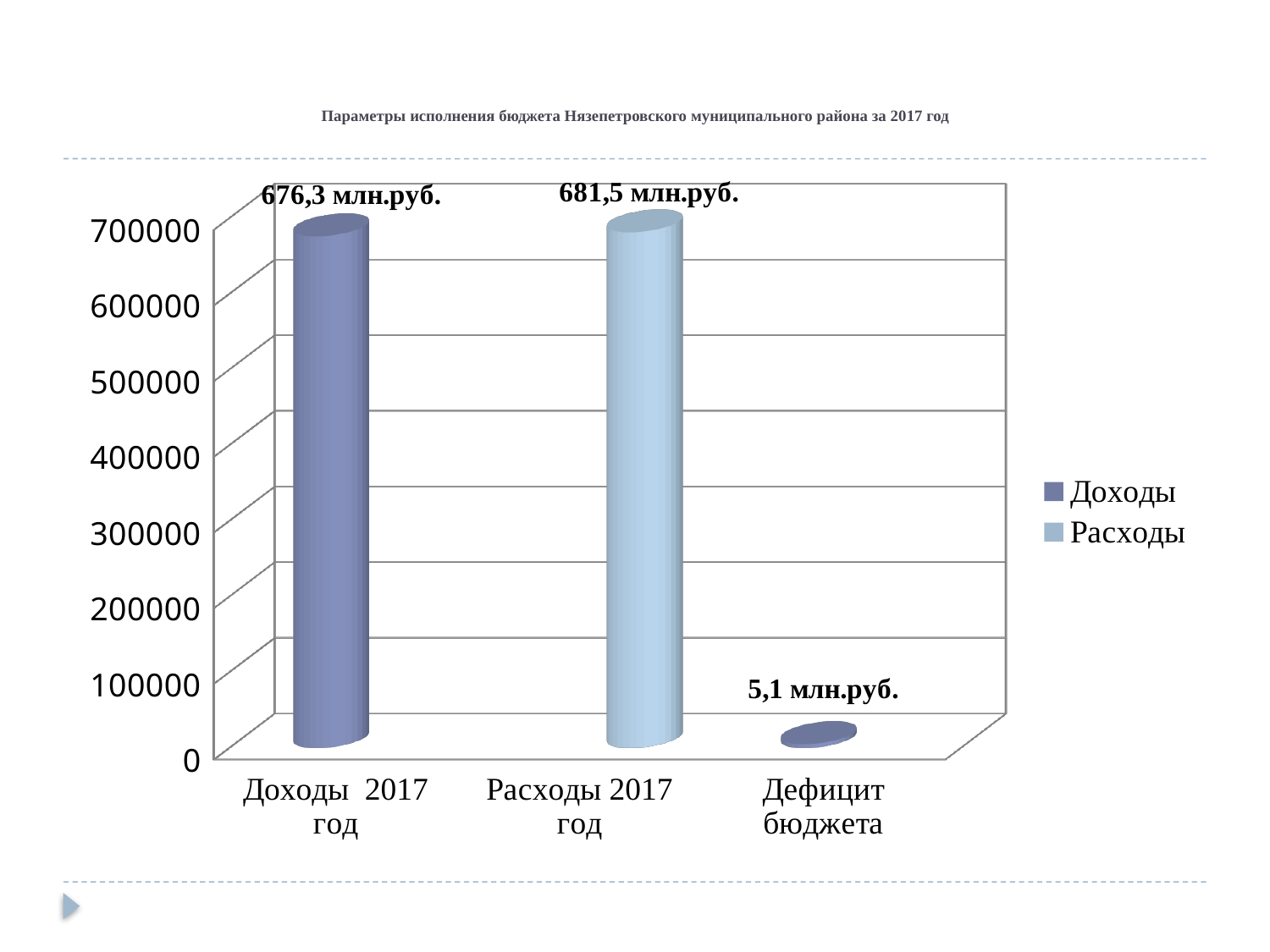
Which is larger, Доходы 2017 год or Расходы 2017 год? Расходы 2017 год Is the bar for Дефицит бюджета greater or less than 100000 on the axis? less What are the two entries in the legend? Доходы and Расходы What value is shown for Дефицит бюджета? 5,1 млн.руб. Which category has the lowest value? Дефицит бюджета What value is shown for Расходы 2017 год? 681,5 млн.руб. How many categories are shown on the x axis? 3 Is the bar for Доходы 2017 год greater or less than 600000 on the axis? greater What value is shown for Доходы 2017 год? 676,3 млн.руб. How many series does the legend list? 2 Which category has the highest value? Расходы 2017 год What kind of chart is shown on the slide? bar chart